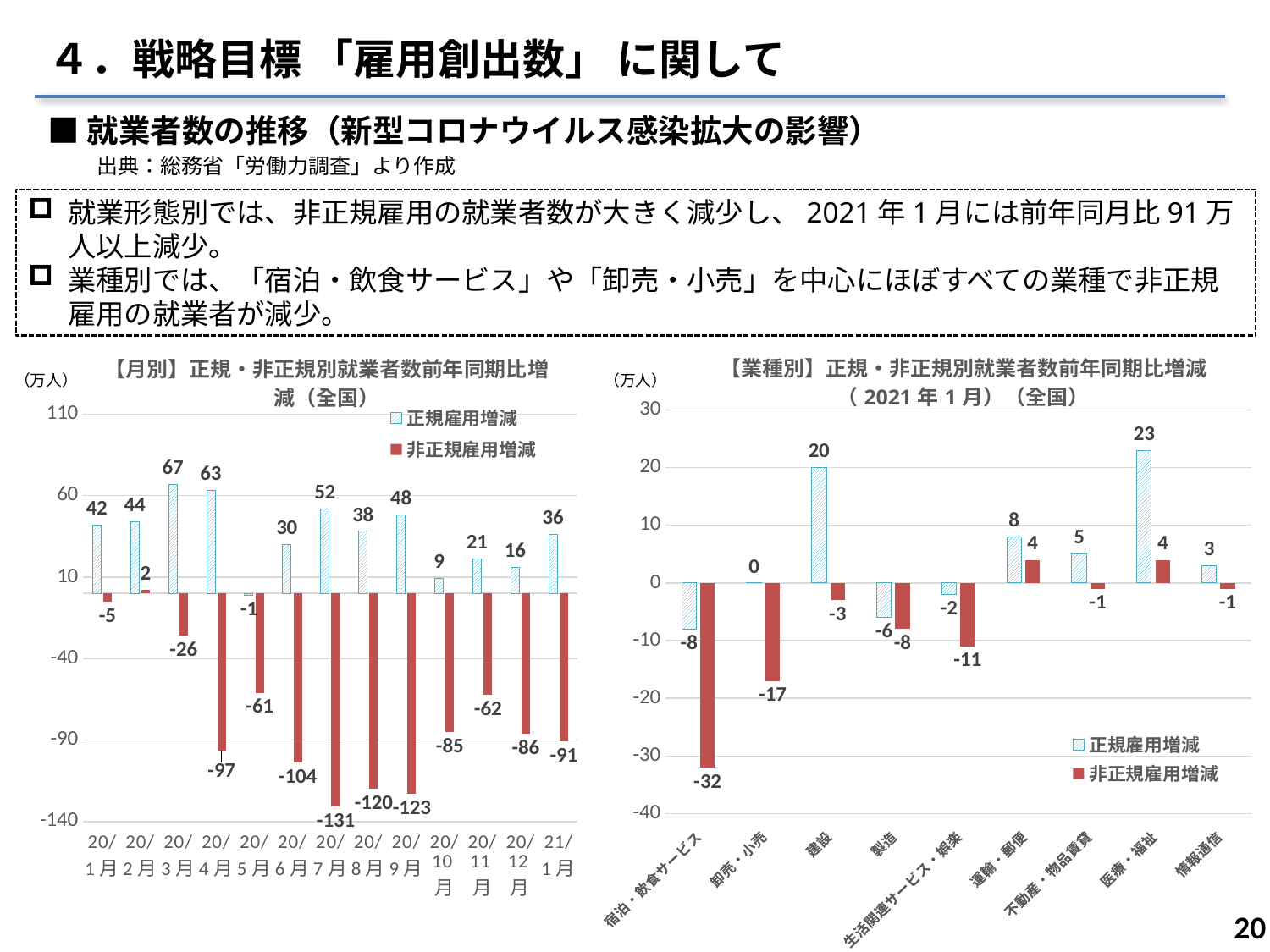
In the left chart (【月別】), what is the value of 正規雇用増減 for 20/3月? 67 In the left chart (【月別】), how many months are shown on the x axis? 13 In the left chart (【月別】), is the 正規雇用増減 value for 20/10月 greater or less than 10? less In the right chart (【業種別】), how many industries are shown on the x axis? 9 In the left chart (【月別】), what is the difference between the 正規雇用増減 values for 20/4月 and 20/5月? 64 In the left chart (【月別】), which month has the lowest 非正規雇用増減 value? 20/7月 In the right chart (【業種別】), which industry has the highest 正規雇用増減 value? 医療・福祉 In the right chart (【業種別】), which is larger, the 非正規雇用増減 value for 卸売・小売 or for 製造? 製造 In the right chart (【業種別】), what is the 非正規雇用増減 value for 宿泊・飲食サービス? -32 What type of chart is the right chart (【業種別】)? bar chart In the left chart (【月別】正規・非正規別就業者数前年同期比増減), what is the value of 非正規雇用増減 for 21/1月? -91 In the right chart (【業種別】), how many series does the legend list? 2